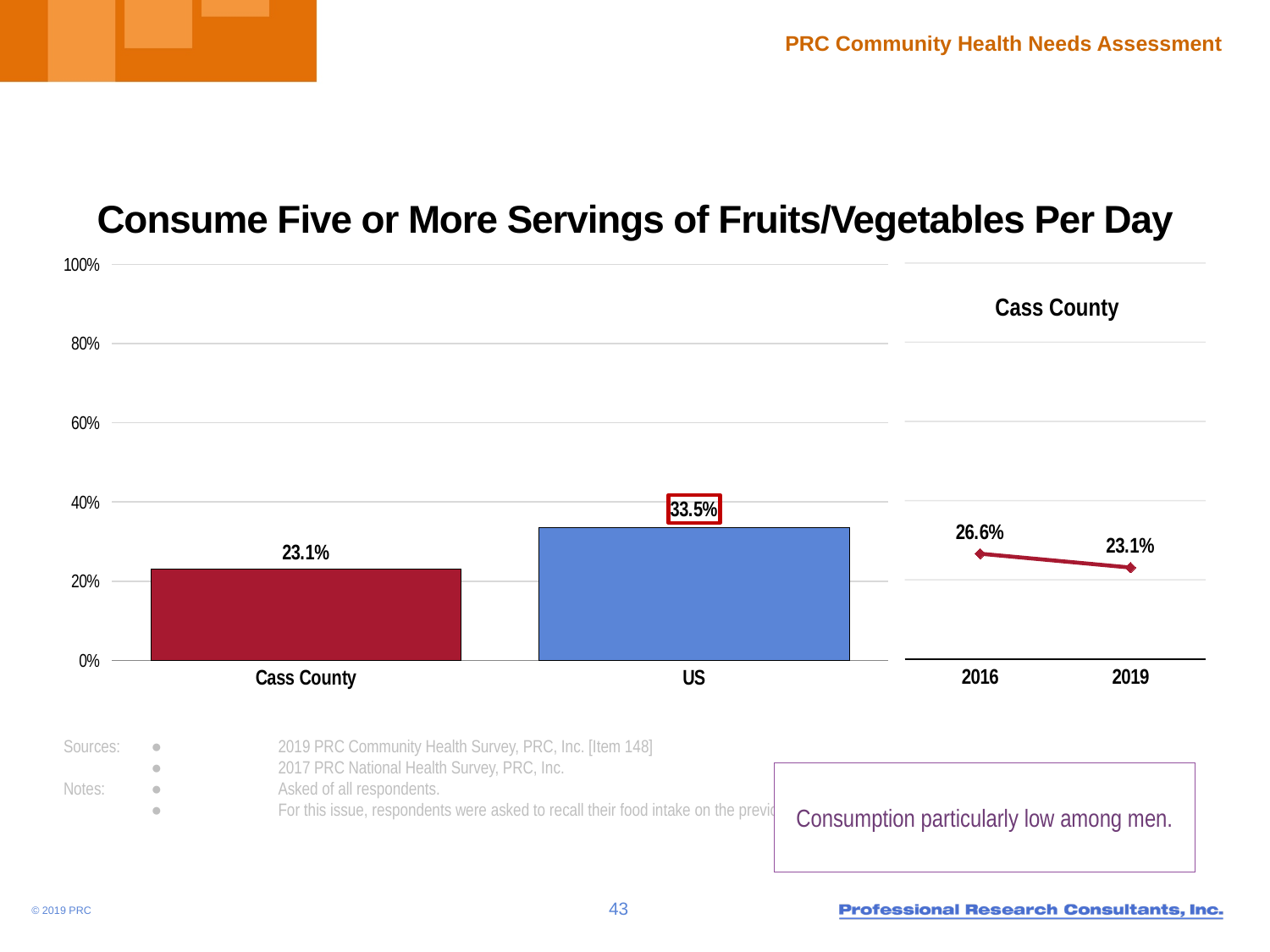
In the Cass County trend chart on the right, do values rise or fall from 2016 to 2019? fall In the Cass County trend chart on the right, what is the value for 2016? 26.6% In the Cass County trend chart on the right, what is the value for 2019? 23.1% In the bar chart on the left, what is the value for Cass County? 23.1% In the Cass County trend chart on the right, what is the difference between the 2016 and 2019 values? 3.5% In the bar chart on the left, what is the difference between the US value and the Cass County value? 10.4% In the bar chart on the left, is the value for US greater or less than 40%? less In the bar chart on the left, what is the value for US? 33.5% In the bar chart on the left, how many bars are shown? 2 In the bar chart on the left, which category has the higher value, Cass County or US? US What kind of chart is the chart on the left? bar chart What is the title of the chart on the slide? Consume Five or More Servings of Fruits/Vegetables Per Day